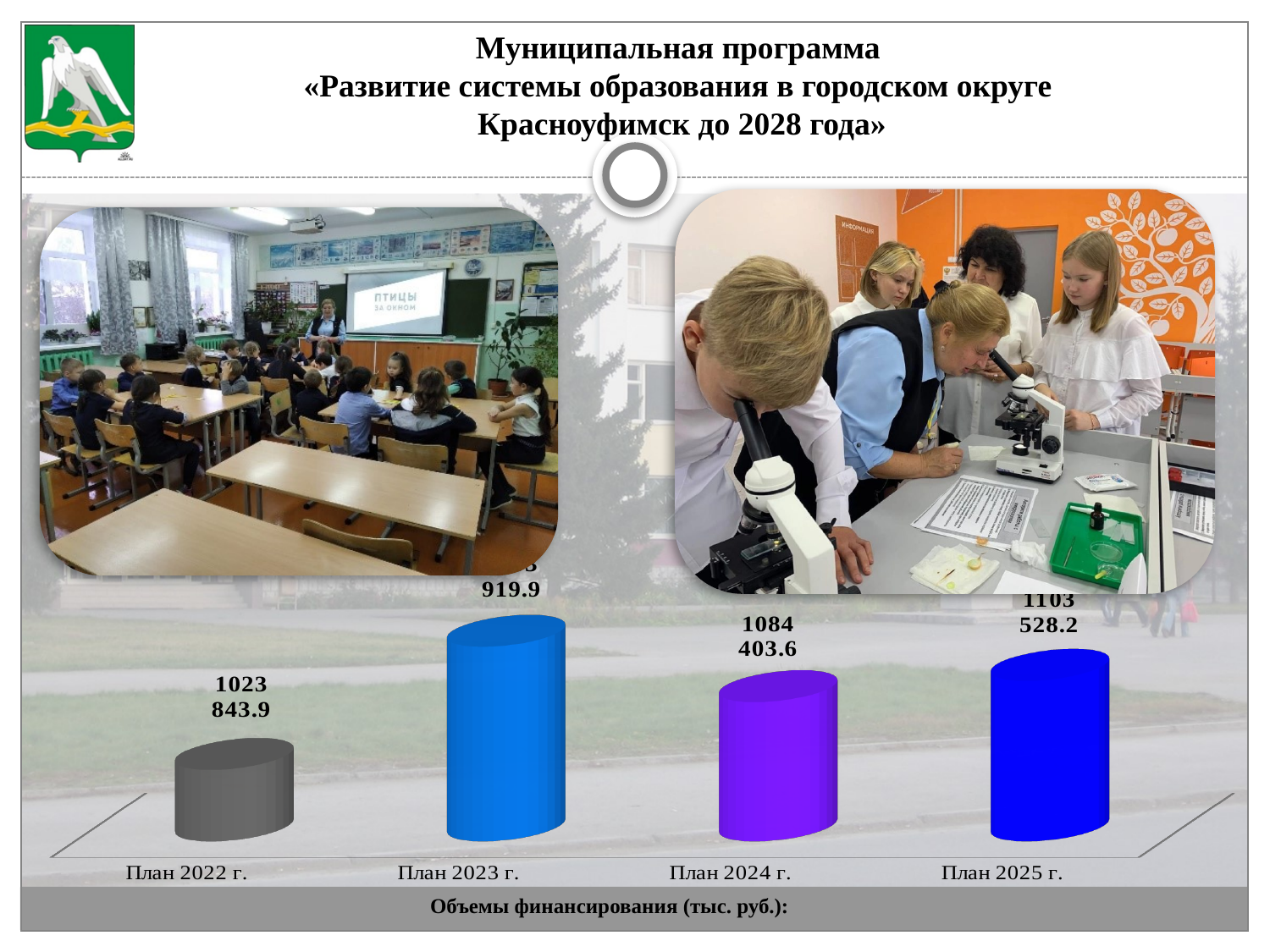
What is the difference between the values for План 2024 г. and План 2022 г.? 60 559.7 What is the value shown for План 2024 г.? 1084 403.6 Which category has the lowest value? План 2022 г. What is the value shown for План 2022 г.? 1023 843.9 What is the difference between the values for План 2025 г. and План 2024 г.? 19 124.6 Which is larger, the value for План 2025 г. or План 2024 г.? План 2025 г. What is the value shown for План 2025 г.? 1103 528.2 Which is larger, the value for План 2022 г. or План 2024 г.? План 2024 г. Which category has the tallest bar? План 2023 г. What unit of measurement is stated in the caption below the chart? тыс. руб. How many categories are shown on the chart? 4 What kind of chart is shown on the slide? Bar chart